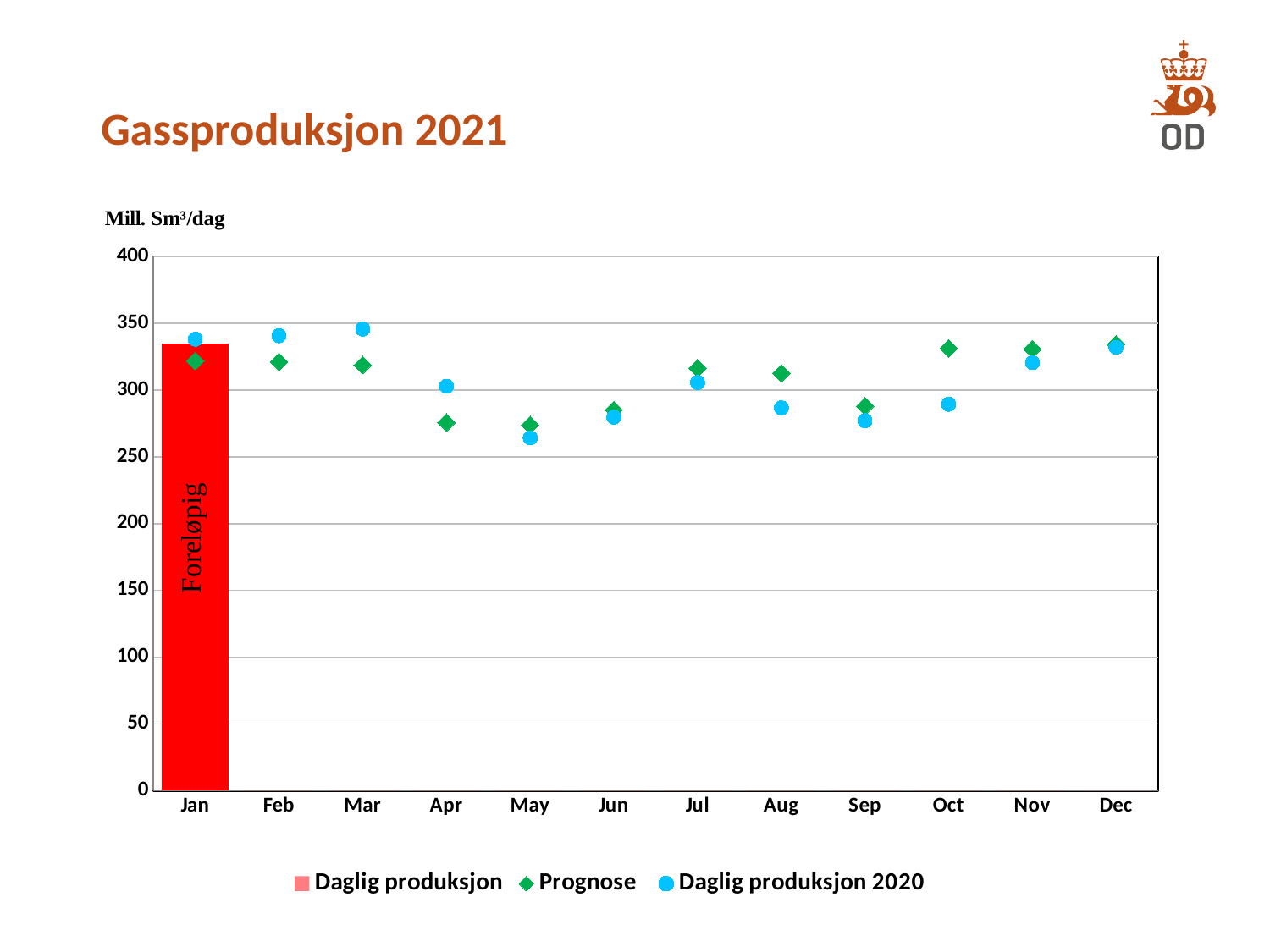
How many series does the legend list? 3 Is the Daglig produksjon bar for Jan greater or less than 350? less How many months are shown on the x axis? 12 In Oct, which is higher: Prognose or Daglig produksjon 2020? Prognose Is the Daglig produksjon bar for Jan greater or less than 300? greater Is the Daglig produksjon 2020 value for Mar greater or less than 300? greater Do the Daglig produksjon 2020 values rise or fall from Mar to May? fall What unit is given above the y axis? Mill. Sm³/dag Which month has a bar for Daglig produksjon? Jan In Apr, which is higher: Prognose or Daglig produksjon 2020? Daglig produksjon 2020 Which month has the lowest Daglig produksjon 2020 value? May